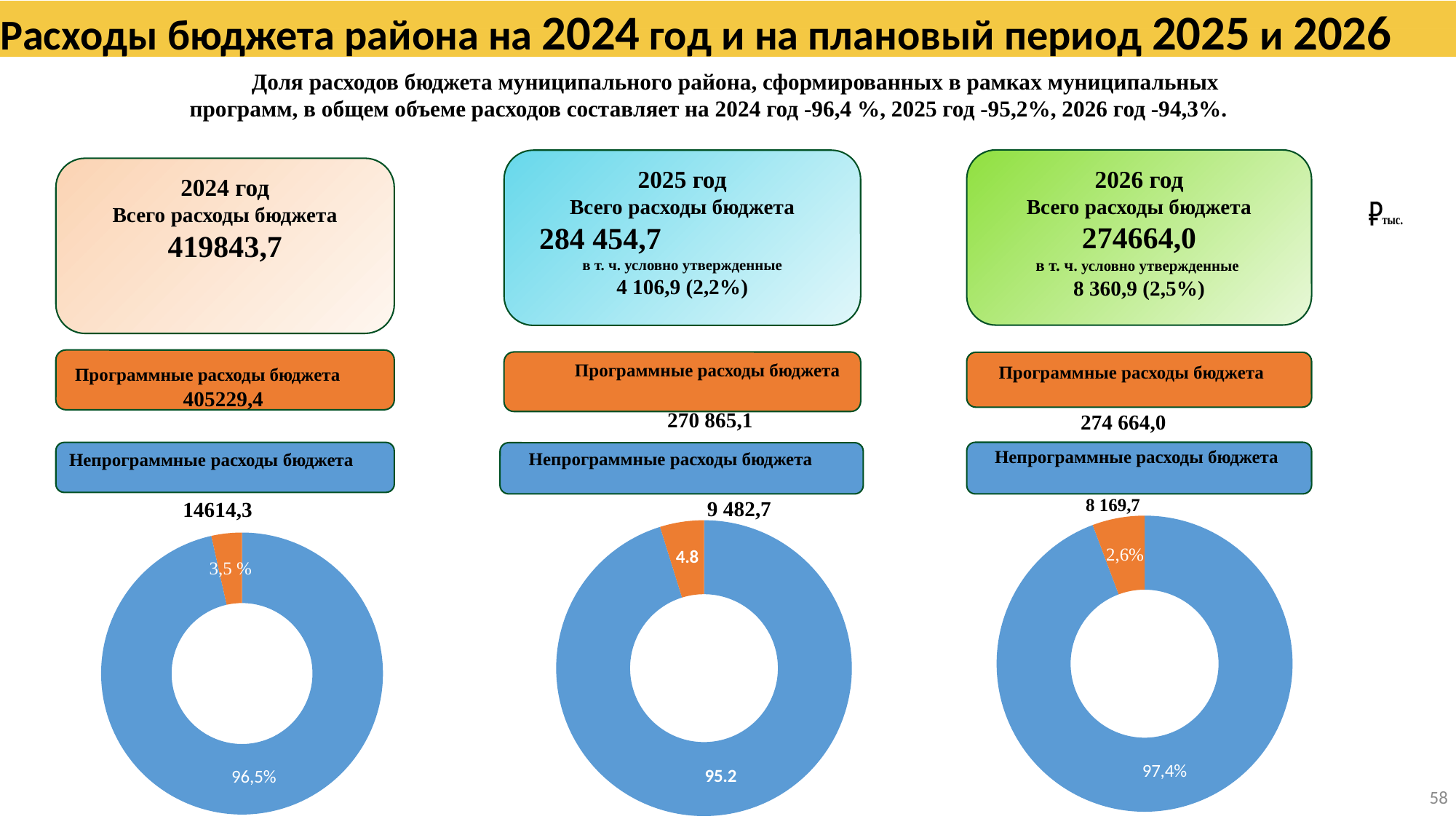
What kind of chart is shown under the 2024 column at the bottom left of the slide? Donut (pie) chart In the middle donut chart (2025), what value is printed on the blue slice? 95.2 In the left donut chart (2024), what share is shown for the large blue slice? 96,5% In the right donut chart (2026), what share is shown for the blue slice? 97,4% In the left donut chart (2024), what share is shown for the small orange slice? 3,5 % In the right donut chart (2026), what share is shown for the orange slice? 2,6% In the right donut chart (2026), which slice is larger, the blue one or the orange one? The blue one In the middle donut chart (2025), what value is printed on the orange slice? 4.8 What colour is the slice representing the larger share in each of the three donut charts? Blue How many slices does the left donut chart (2024) have? 2